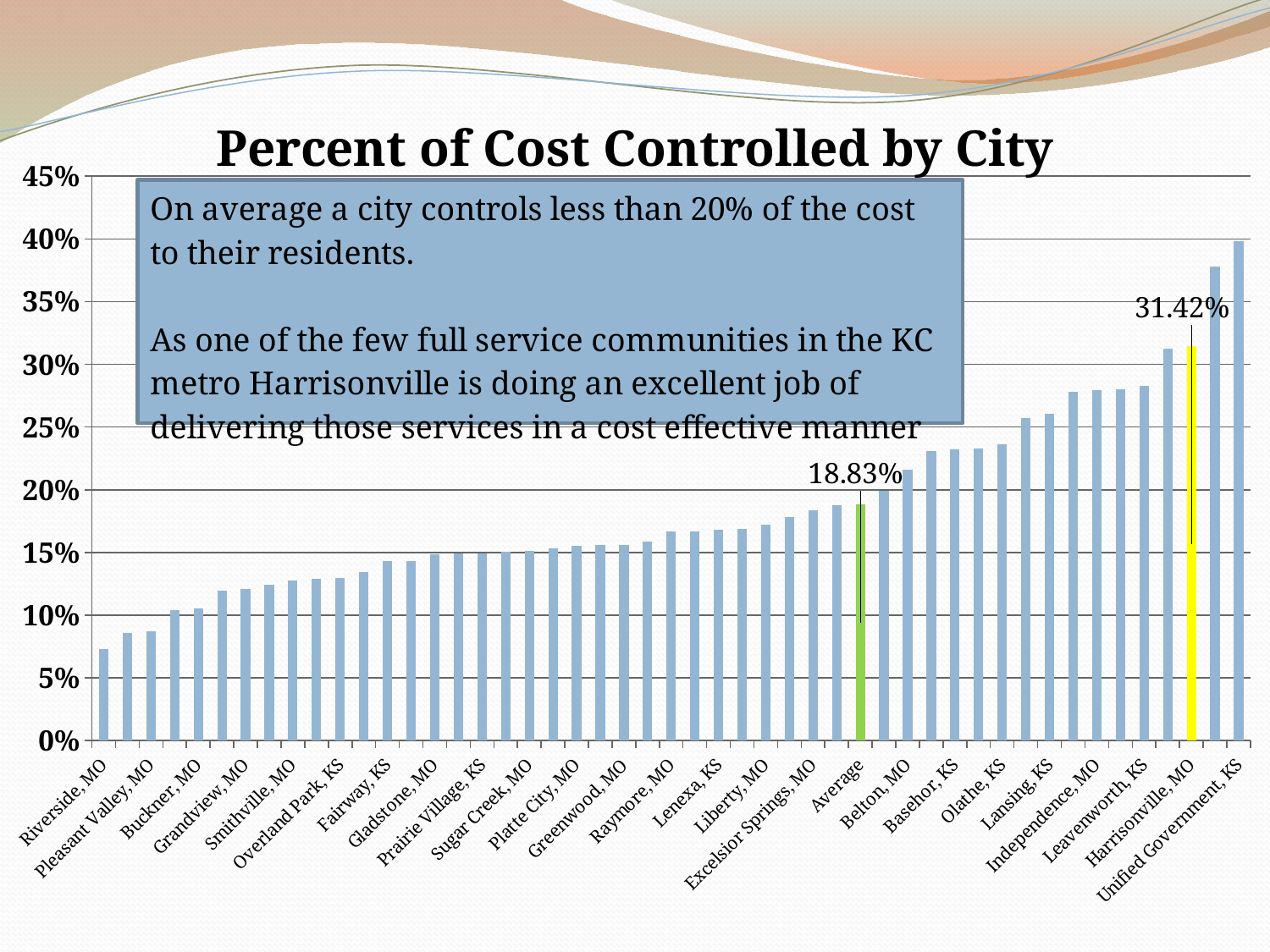
Which is larger, the value for Harrisonville, MO or the Average value? Harrisonville, MO Is the value for Independence, MO greater or less than 25%? greater Do the values rise or fall from left to right along the x axis? rise Is the value for Unified Government, KS greater or less than 35%? greater What is the value for Harrisonville, MO? 31.42% Which category has the lowest value? Riverside, MO Is the value for Overland Park, KS greater or less than 15%? less What is the value for Average? 18.83% What kind of chart is shown on the slide? bar chart What is the difference between the value for Harrisonville, MO and the Average value? 12.59 percentage points Which category has the highest value? Unified Government, KS